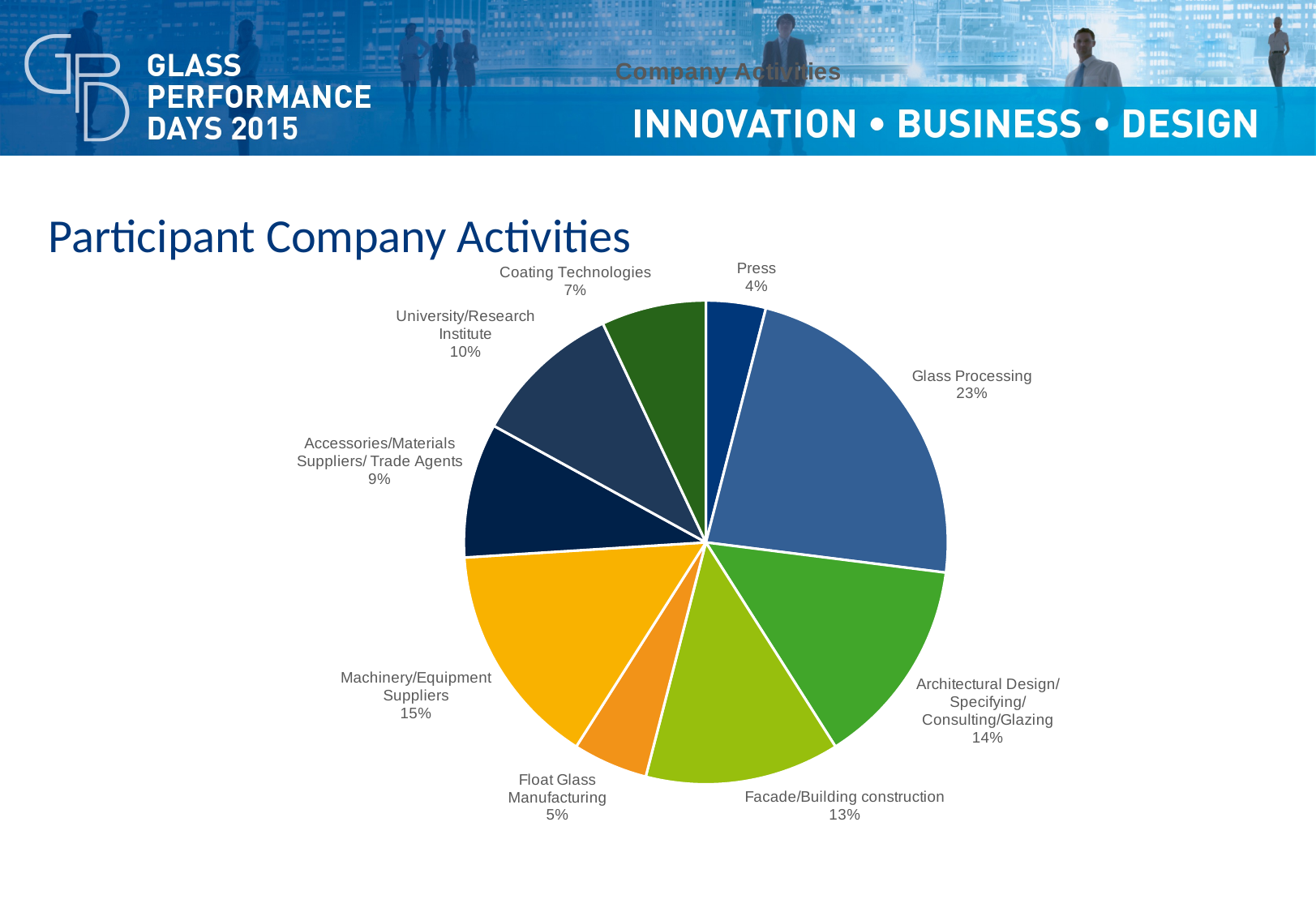
What kind of chart is shown on the slide? Pie chart What percentage is shown for Press? 4% What is the difference in percentage points between Glass Processing and Machinery/Equipment Suppliers? 8 How many categories are shown in the pie chart? 9 What is the value shown for Machinery/Equipment Suppliers? 15% What share of the pie does Glass Processing represent? 23% What is the value shown for Float Glass Manufacturing? 5% Which category has the smallest slice of the pie? Press Which category has the largest slice of the pie? Glass Processing What is the combined share of Coating Technologies and University/Research Institute? 17% What is the title of the chart on the slide? Company Activities Which is larger, Facade/Building construction or University/Research Institute? Facade/Building construction